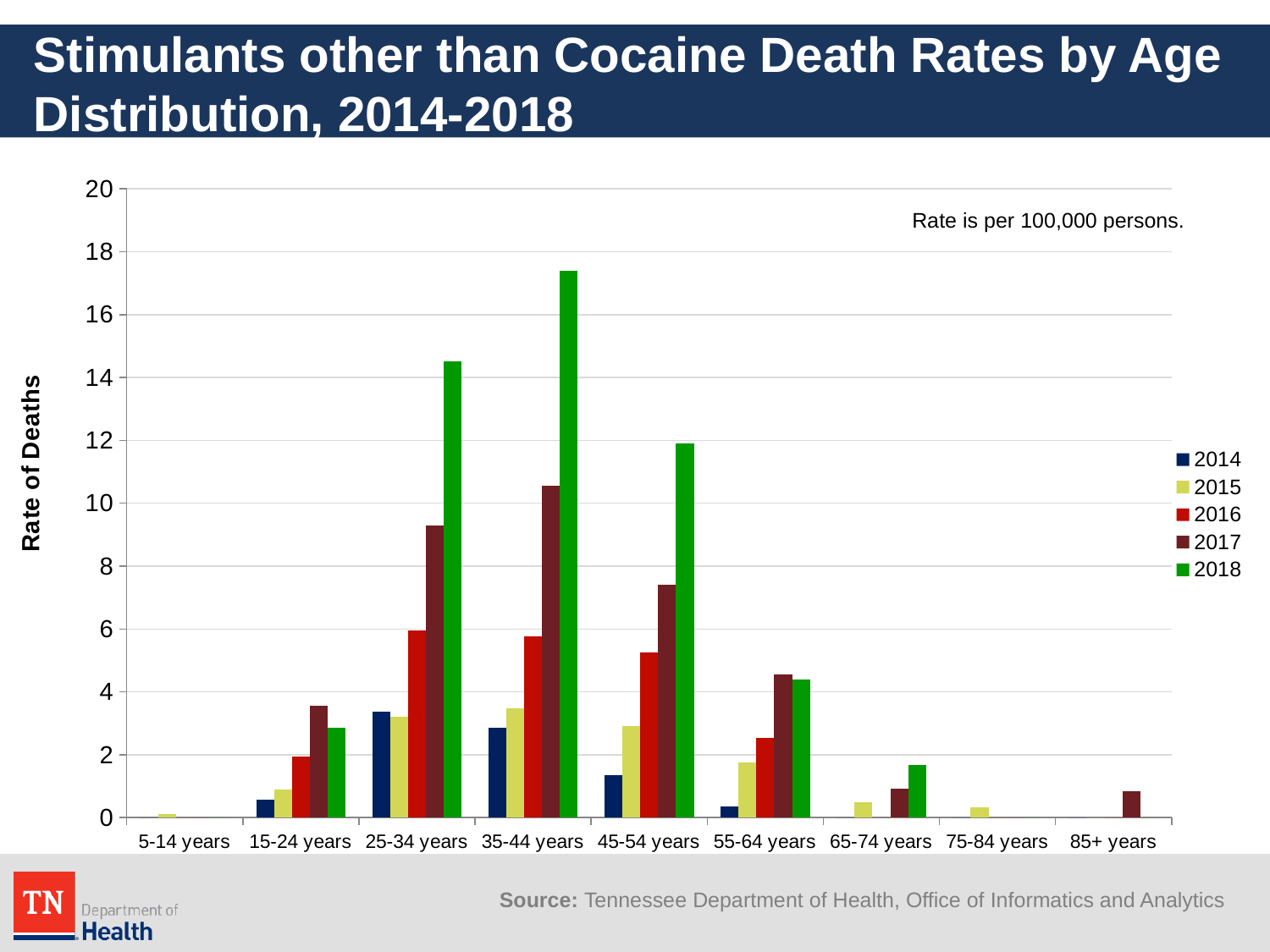
For 25-34 years, which is larger, the 2017 value or the 2018 value? 2018 Is the 2018 value for 35-44 years greater or less than 16? greater Is the 2017 value for 35-44 years greater or less than 10? greater What unit does the note on the chart say the rate is expressed in? per 100,000 persons How many age groups are shown on the x axis? 9 Which age group has the highest 2018 death rate? 35-44 years Is the 2016 value for 45-54 years greater or less than 4? greater How many series does the legend list? 5 What kind of chart is shown on the slide? bar chart Which age group has the highest 2017 death rate? 35-44 years Which age group has the highest 2014 death rate? 25-34 years